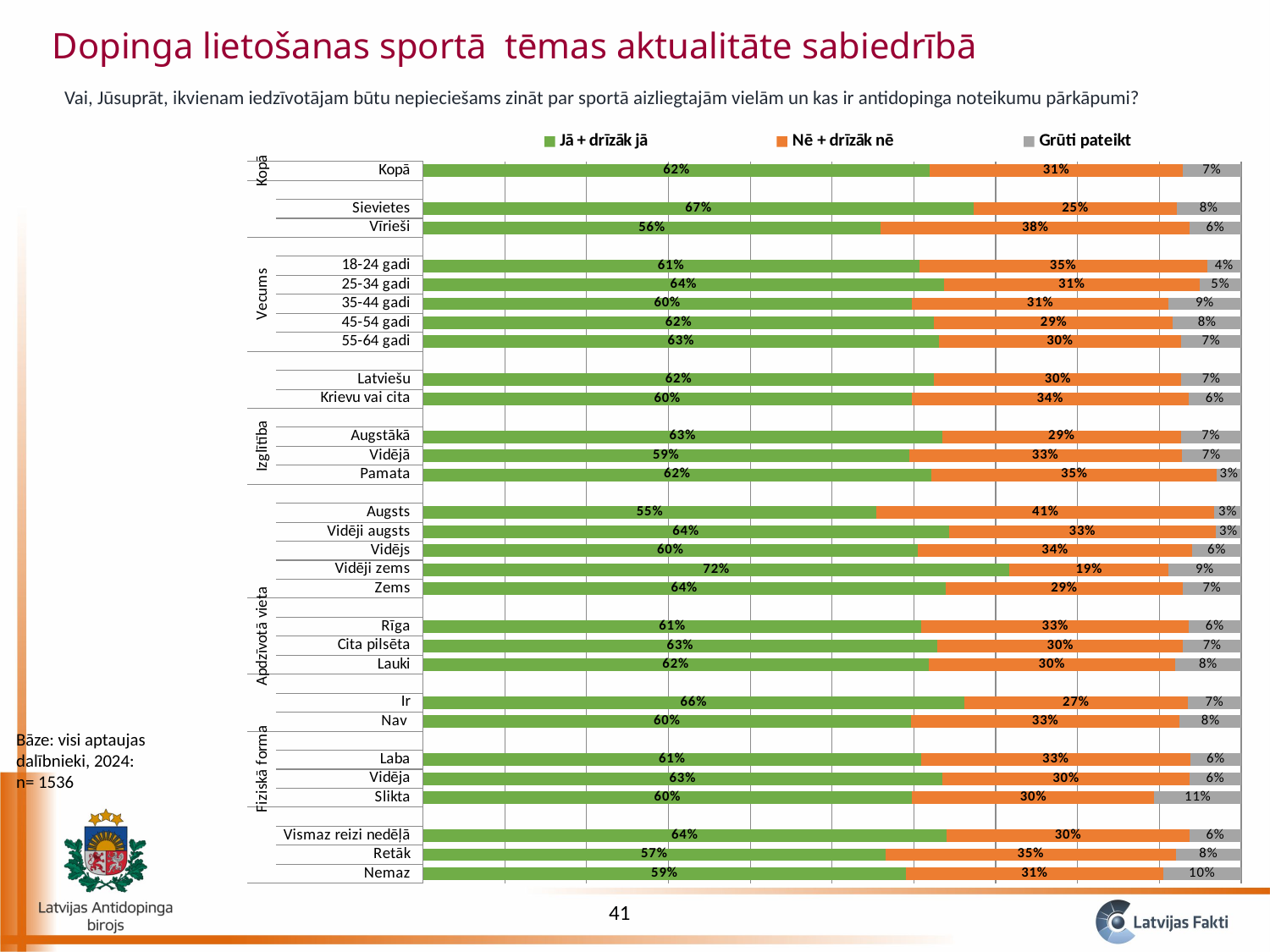
What is the value of "Grūti pateikt" for Slikta? 11% What is the value of "Grūti pateikt" for 18-24 gadi? 4% Which category has the highest "Nē + drīzāk nē" value? Augsts What is the value of "Jā + drīzāk jā" for Kopā? 62% Which has a larger "Nē + drīzāk nē" value, Retāk or Nemaz? Retāk What is the total of the three segments for the Vidēji zems bar? 100% What is the value of "Nē + drīzāk nē" for Vīrieši? 38% What kind of chart is shown on the slide? Stacked bar chart How many series does the legend list? 3 Which category has the lowest "Jā + drīzāk jā" value? Augsts Which category has the highest "Jā + drīzāk jā" value? Vidēji zems What is the difference between the "Jā + drīzāk jā" values for Sievietes and Vīrieši? 11 percentage points